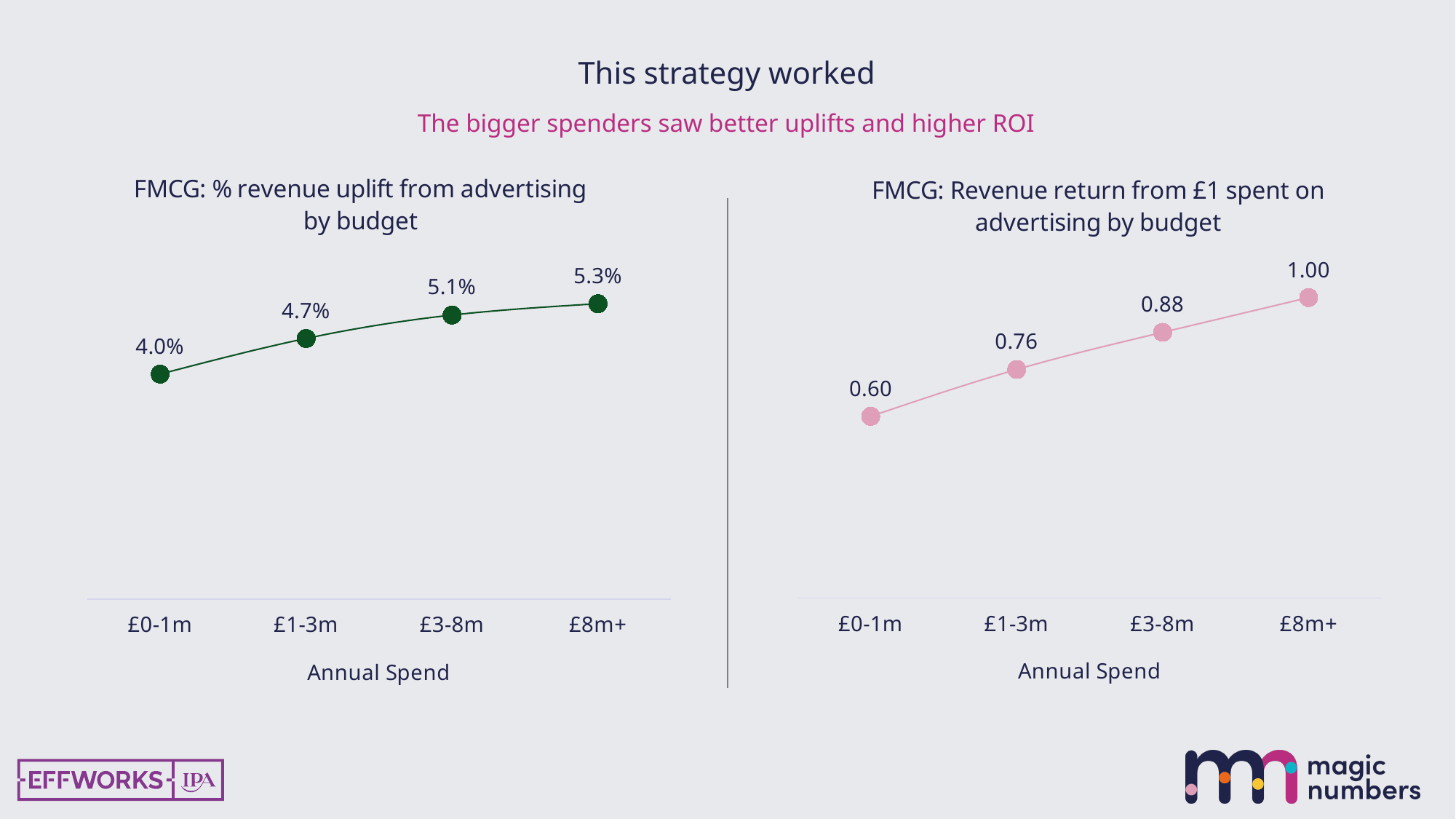
In the left chart (FMCG: % revenue uplift from advertising by budget), which budget band has the highest revenue uplift? £8m+ In the right chart (FMCG: Revenue return from £1 spent on advertising by budget), what is the difference in revenue return between the £1-3m and £0-1m budgets? 0.16 In the right chart (FMCG: Revenue return from £1 spent on advertising by budget), what is the revenue return for the £3-8m budget? 0.88 In the left chart (FMCG: % revenue uplift from advertising by budget), what is the difference in revenue uplift between the £8m+ and £0-1m budgets? 1.3% What kind of chart is the right chart (FMCG: Revenue return from £1 spent on advertising by budget)? Line chart What is the title of the left chart on the slide? FMCG: % revenue uplift from advertising by budget In the right chart (FMCG: Revenue return from £1 spent on advertising by budget), which budget band has the larger revenue return, £1-3m or £3-8m? £3-8m In the left chart (FMCG: % revenue uplift from advertising by budget), do the values rise or fall as annual spend increases? Rise What is the x-axis label on the right chart (FMCG: Revenue return from £1 spent on advertising by budget)? Annual Spend In the left chart (FMCG: % revenue uplift from advertising by budget), what is the revenue uplift for the £1-3m budget? 4.7% In the right chart (FMCG: Revenue return from £1 spent on advertising by budget), which budget band has the lowest revenue return? £0-1m How many budget bands are plotted in the left chart (FMCG: % revenue uplift from advertising by budget)? 4